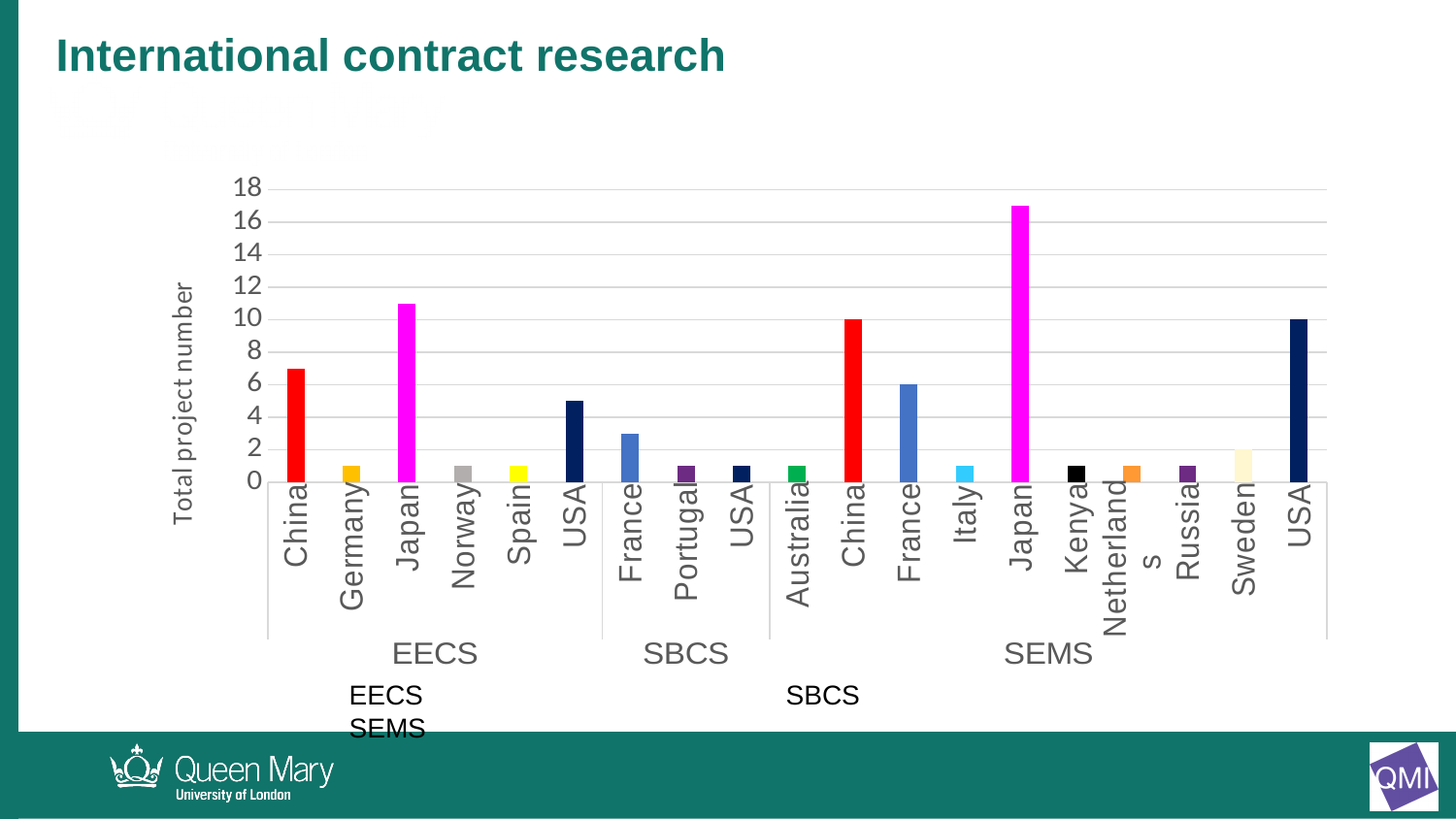
What is the total project number for France in the SEMS group? 6 Is the total project number for Japan in the EECS group greater or less than 8? greater Which bar is the tallest in the whole chart? Japan (SEMS) What kind of chart is shown on the slide? bar chart Is the total project number for France in the SBCS group greater or less than 4? less Which is larger, the total project number for China in EECS or China in SEMS? China in SEMS What is the difference between the total project number for USA and France in the SEMS group? 4 What is the total project number for Sweden in the SEMS group? 2 What is the label on the vertical axis of the chart? Total project number What is the title of the chart? International contract research Which country in the SEMS group has the highest total project number? Japan What is the total project number for China in the SEMS group? 10